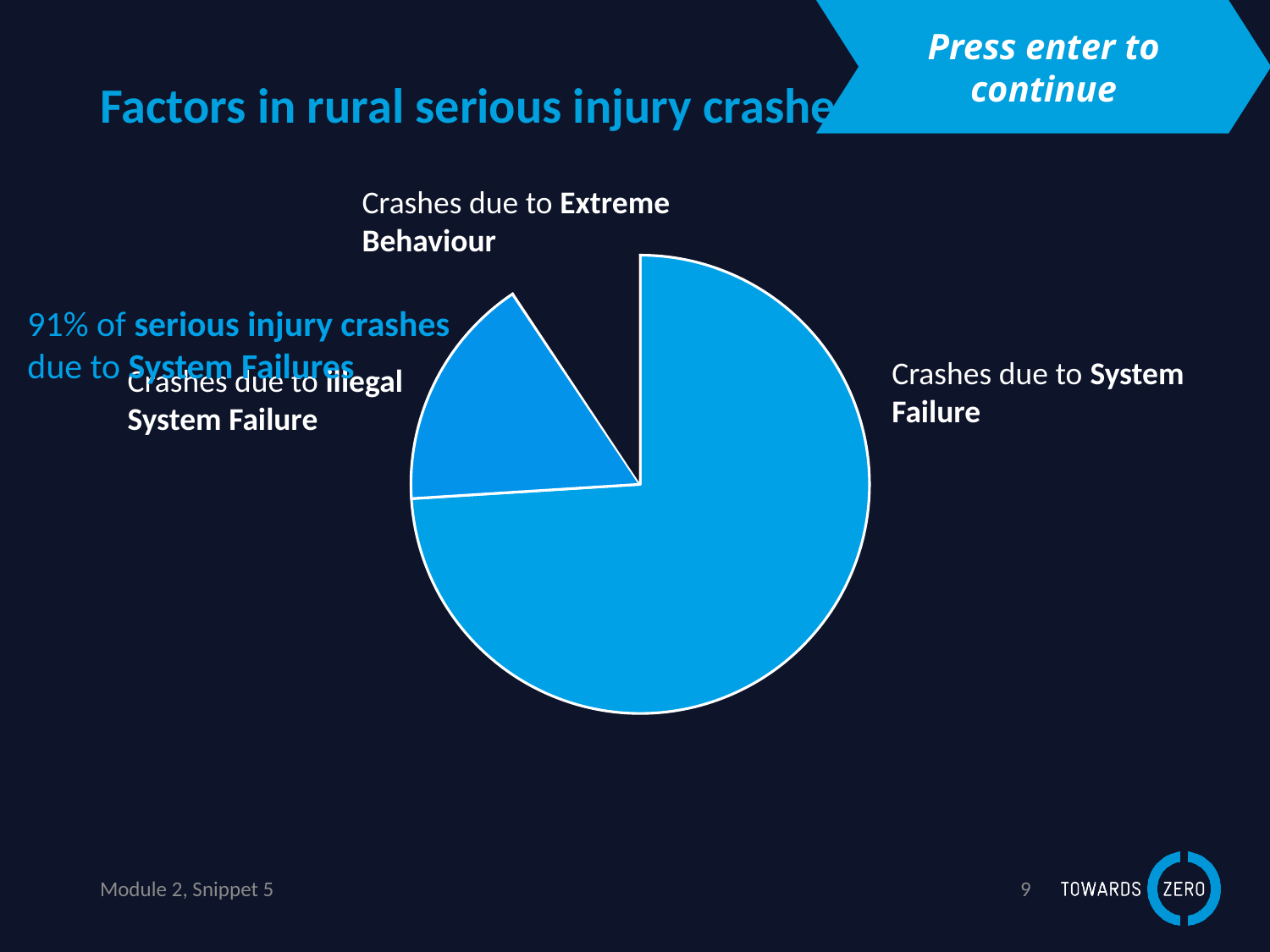
Is the share of the pie for Crashes due to System Failure greater or less than 50%? greater Which slice of the pie chart is the largest? Crashes due to System Failure Which is larger in the pie chart: the slice for Crashes due to System Failure or the slice for Crashes due to Extreme Behaviour? Crashes due to System Failure What kind of chart is shown on the slide? pie chart What is the title of the slide containing the pie chart? Factors in rural serious injury crashes What colour is the largest slice of the pie chart? light blue Of the slices for Crashes due to System Failure and Crashes due to Extreme Behaviour, which is smaller? Crashes due to Extreme Behaviour